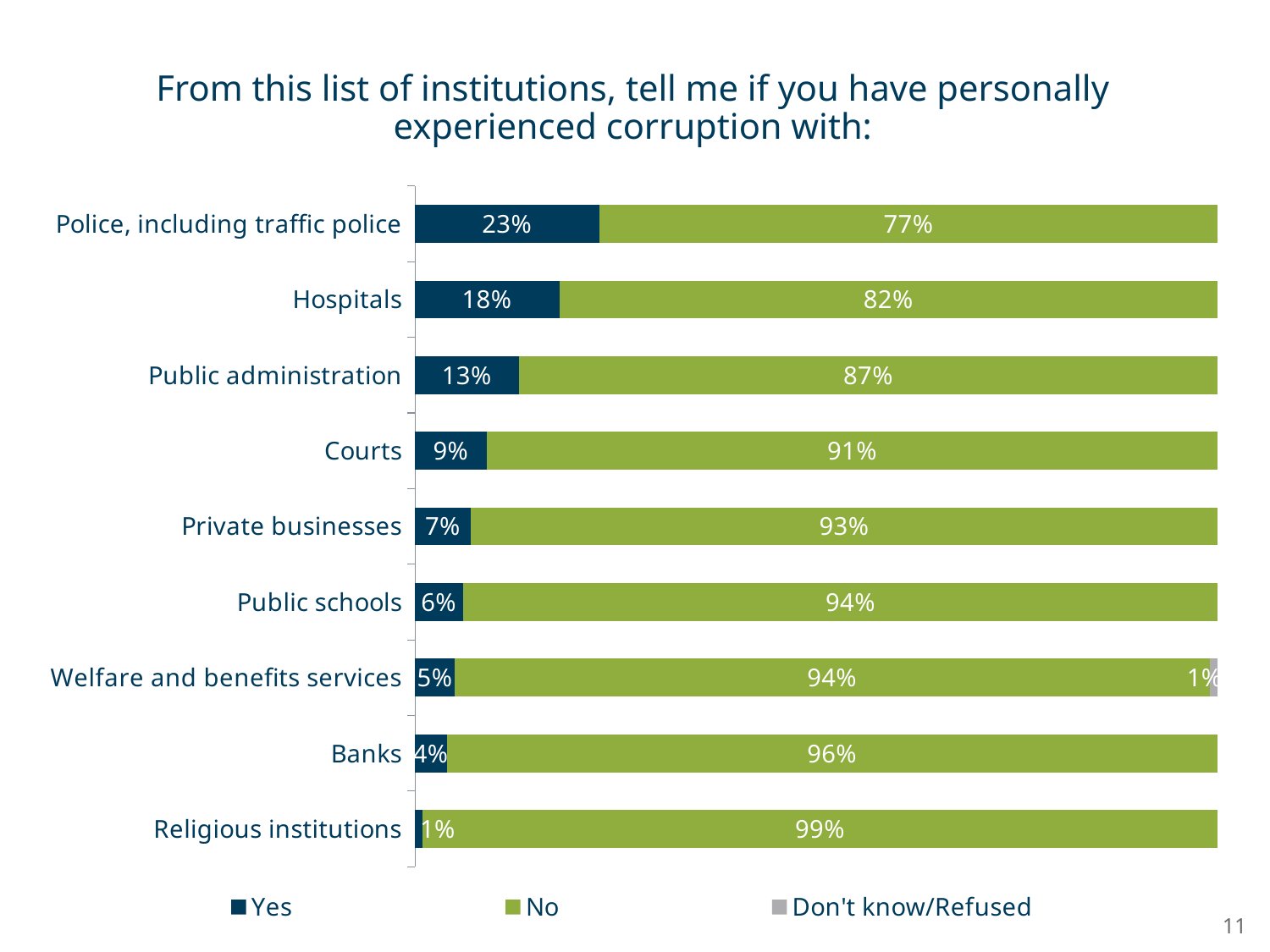
Which has a higher Yes value, Courts or Private businesses? Courts What is the difference between the Yes values for Police, including traffic police and Hospitals? 5% What is the Don't know/Refused value for Welfare and benefits services? 1% How many series does the legend list? 3 What percentage of respondents said No for Hospitals? 82% What percentage of respondents said Yes for Police, including traffic police? 23% What kind of chart is shown on the slide? Stacked bar chart Which series is shown in green in the chart? No How many institutions are listed in the chart? 9 Which institution has the highest Yes percentage? Police, including traffic police Which institution has the lowest Yes percentage? Religious institutions What is the Yes value for Public administration? 13%